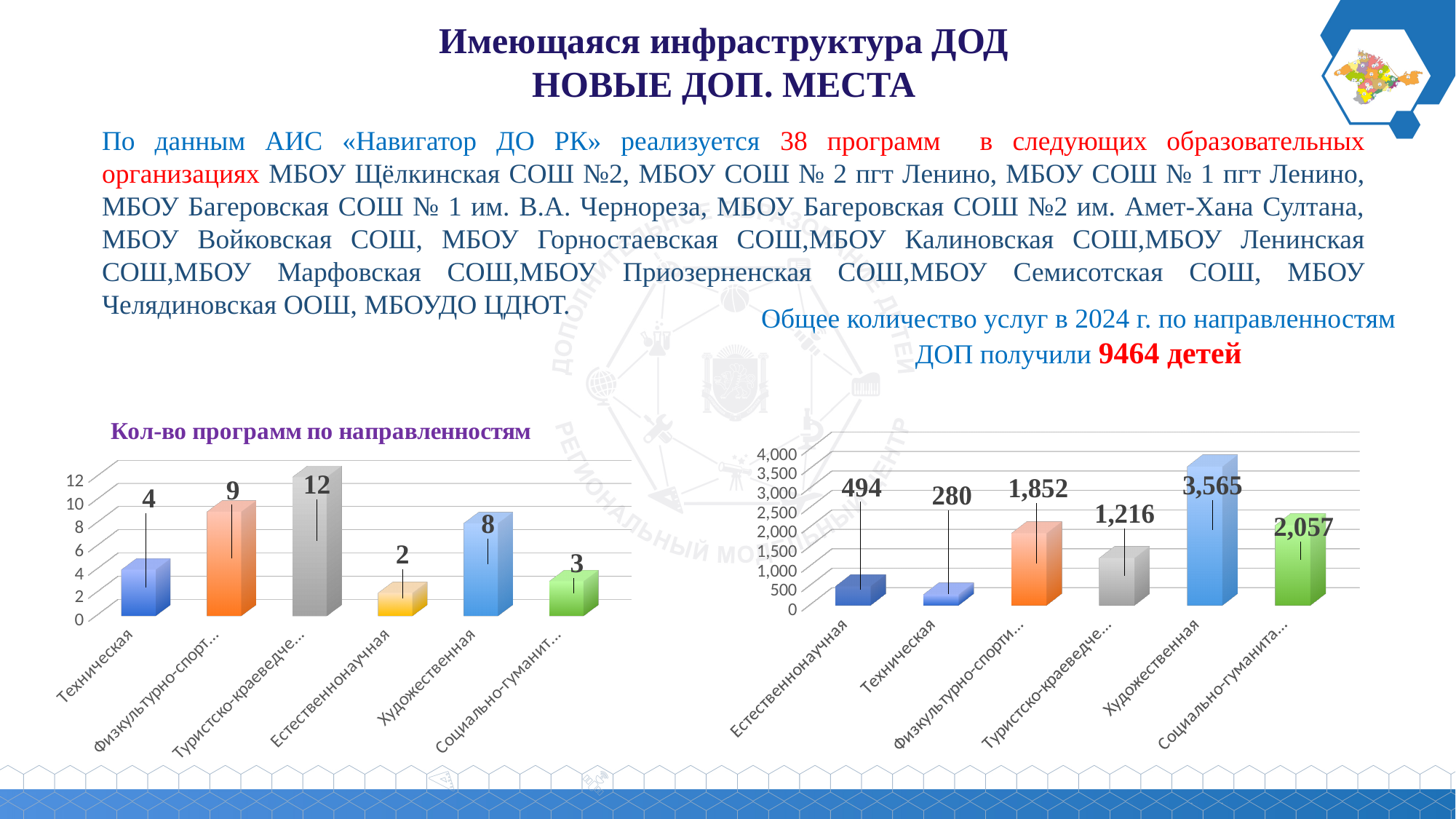
In the right-hand chart, what is the difference between the values for Художественная and Туристско-краеведческая? 2,349 In the right-hand chart, which is larger: the value for Социально-гуманитарная or the value for Физкультурно-спортивная? Социально-гуманитарная What type of chart is the chart titled «Кол-во программ по направленностям»? Bar chart In the right-hand chart, what is the value for Художественная? 3,565 In the right-hand chart, what is the value for Техническая? 280 In the chart titled «Кол-во программ по направленностям», which category has the highest value? Туристско-краеведческая In the chart titled «Кол-во программ по направленностям», what is the difference between the values for Физкультурно-спортивная and Техническая? 5 In the right-hand chart, is the value for Естественнонаучная greater or less than 500? less In the chart titled «Кол-во программ по направленностям», how many programs are shown for Художественная? 8 In the chart titled «Кол-во программ по направленностям», which category has the lowest value? Естественнонаучная In the right-hand chart, which category has the lowest value? Техническая In the chart titled «Кол-во программ по направленностям», how many categories are shown? 6